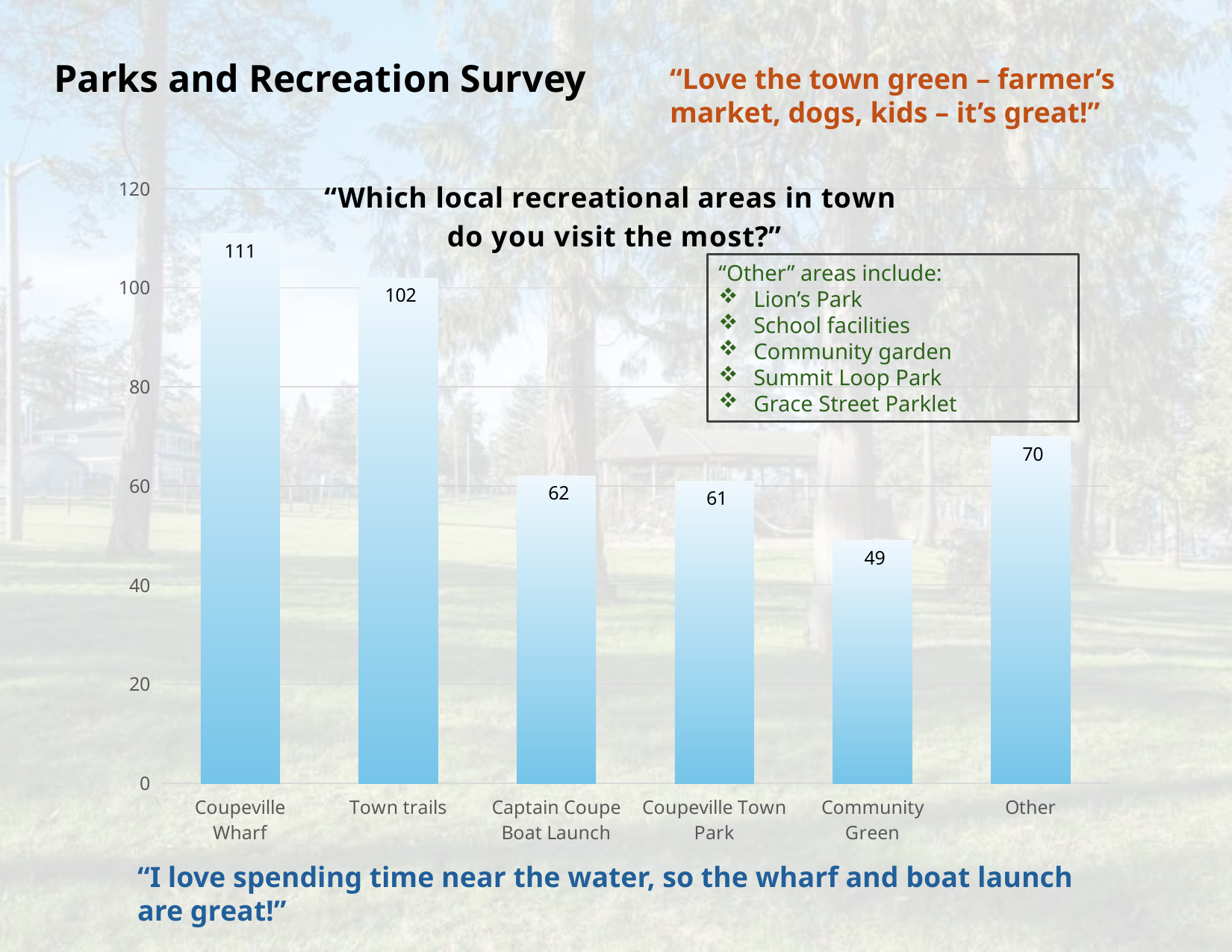
What is the value for Town trails? 102 What is the value for Other? 70 Which category has the lowest value? Community Green What is the value for Coupeville Wharf? 111 What is the title of the chart? "Which local recreational areas in town do you visit the most?" What is the value for Community Green? 49 What is the difference between the values for Other and Community Green? 21 Which is larger, the value for Other or the value for Captain Coupe Boat Launch? Other Which category has the highest value? Coupeville Wharf What is the difference between the values for Coupeville Wharf and Town trails? 9 What kind of chart is shown on the slide? Bar chart How many categories are shown on the x axis? 6